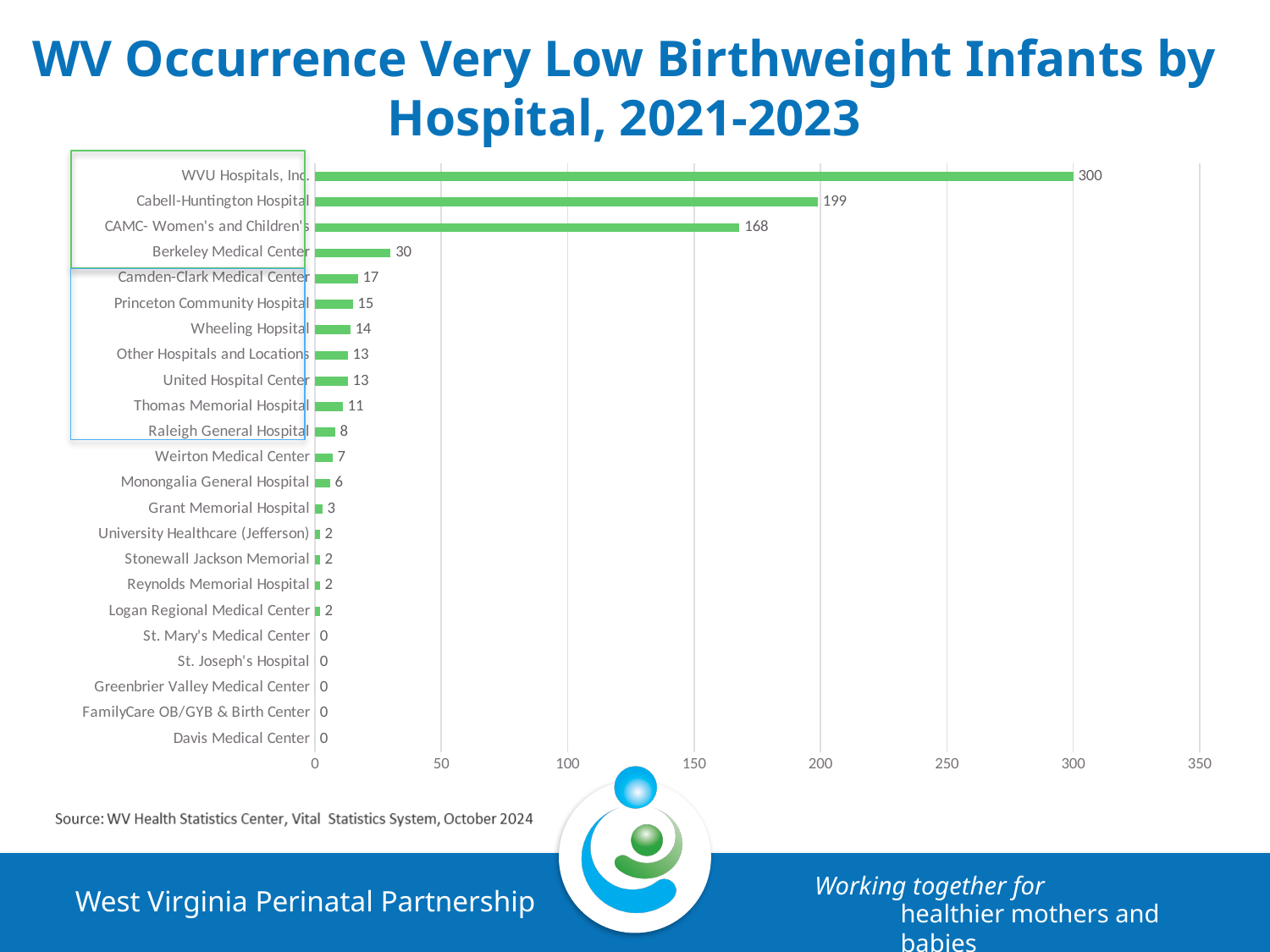
What is the value for Cabell-Huntington Hospital? 199 What is the title of the chart? WV Occurrence Very Low Birthweight Infants by Hospital, 2021-2023 What is the difference between the values for WVU Hospitals, Inc. and Cabell-Huntington Hospital? 101 What is the value for Thomas Memorial Hospital? 11 How many hospitals have a value of 0? 5 What is the difference between the values for Cabell-Huntington Hospital and CAMC- Women's and Children's? 31 How many hospitals/categories are listed on the chart? 23 Which is larger, the value for Camden-Clark Medical Center or Princeton Community Hospital? Camden-Clark Medical Center What is the value for Berkeley Medical Center? 30 What is the value for WVU Hospitals, Inc.? 300 What type of chart is shown on the slide? bar chart Which hospital has the highest value? WVU Hospitals, Inc.